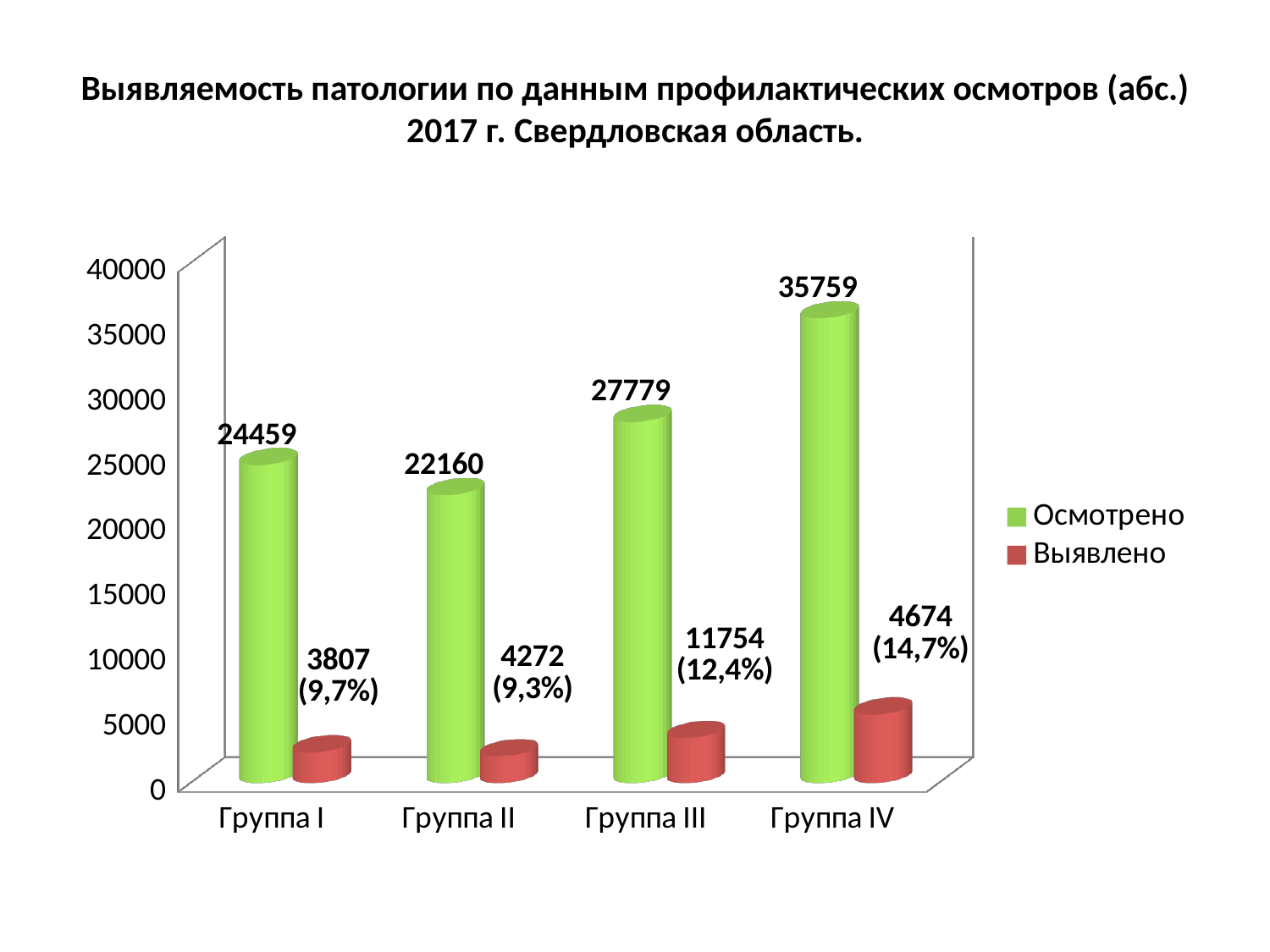
What is the difference between the Осмотрено values for Группа I and Группа II? 2299 Which group has the lowest Осмотрено value? Группа II What percentage is shown next to the Выявлено value for Группа IV? 14,7% How many series does the legend list? 2 Which group has the highest Осмотрено value? Группа IV What is the value of Выявлено for Группа I? 3807 What is the value of Осмотрено for Группа IV? 35759 What is the value of Осмотрено for Группа II? 22160 What is the difference between the Осмотрено values for Группа IV and Группа III? 7980 How many groups are shown on the x axis? 4 Which has a larger Осмотрено value, Группа I or Группа III? Группа III Is the Выявлено value for Группа II greater or less than 5000? less